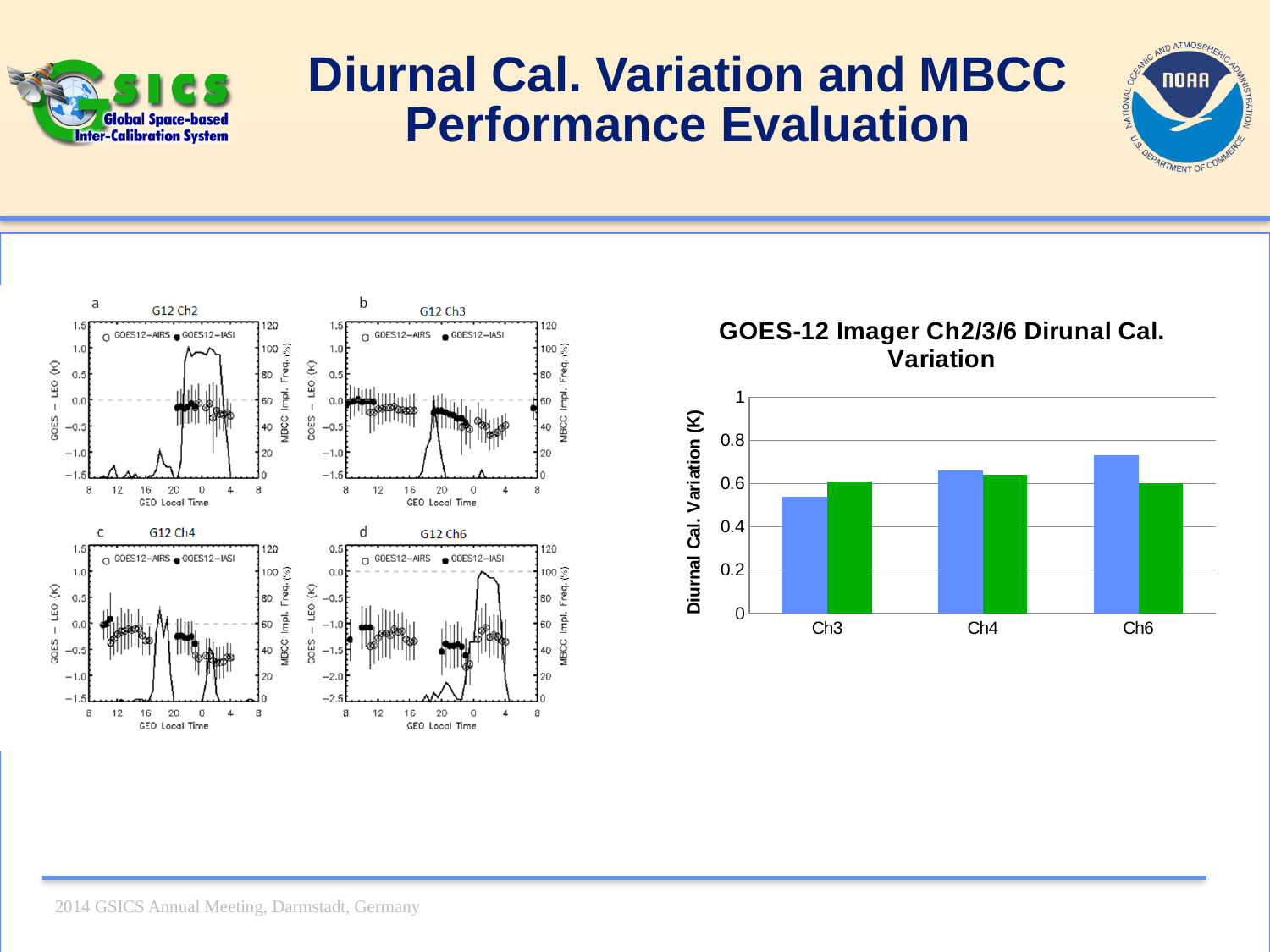
In the 'GOES-12 Imager Ch2/3/6 Dirunal Cal. Variation' bar chart, which channel has the shortest blue bar? Ch3 In the 'GOES-12 Imager Ch2/3/6 Dirunal Cal. Variation' bar chart, is the blue bar for Ch6 greater or less than 0.8? less In the 'GOES-12 Imager Ch2/3/6 Dirunal Cal. Variation' bar chart, which channel has the tallest blue bar? Ch6 In the 'GOES-12 Imager Ch2/3/6 Dirunal Cal. Variation' bar chart, do the blue bars rise or fall going from Ch3 to Ch6? rise In the four-panel figure on the left of the slide, what is the title of panel d? G12 Ch6 In the 'GOES-12 Imager Ch2/3/6 Dirunal Cal. Variation' bar chart, is the blue bar for Ch4 greater or less than 0.6? greater In the 'GOES-12 Imager Ch2/3/6 Dirunal Cal. Variation' bar chart, is the blue bar for Ch3 greater or less than 0.6? less In the 'GOES-12 Imager Ch2/3/6 Dirunal Cal. Variation' bar chart, how many channel categories are shown on the x axis? 3 What is the y-axis label of the 'GOES-12 Imager Ch2/3/6 Dirunal Cal. Variation' bar chart? Diurnal Cal. Variation (K) In the 'GOES-12 Imager Ch2/3/6 Dirunal Cal. Variation' bar chart, how many bars are plotted for each channel? 2 In the 'GOES-12 Imager Ch2/3/6 Dirunal Cal. Variation' bar chart, for Ch6, which bar is taller, the blue one or the green one? blue What kind of chart is the 'GOES-12 Imager Ch2/3/6 Dirunal Cal. Variation' chart on the right of the slide? bar chart